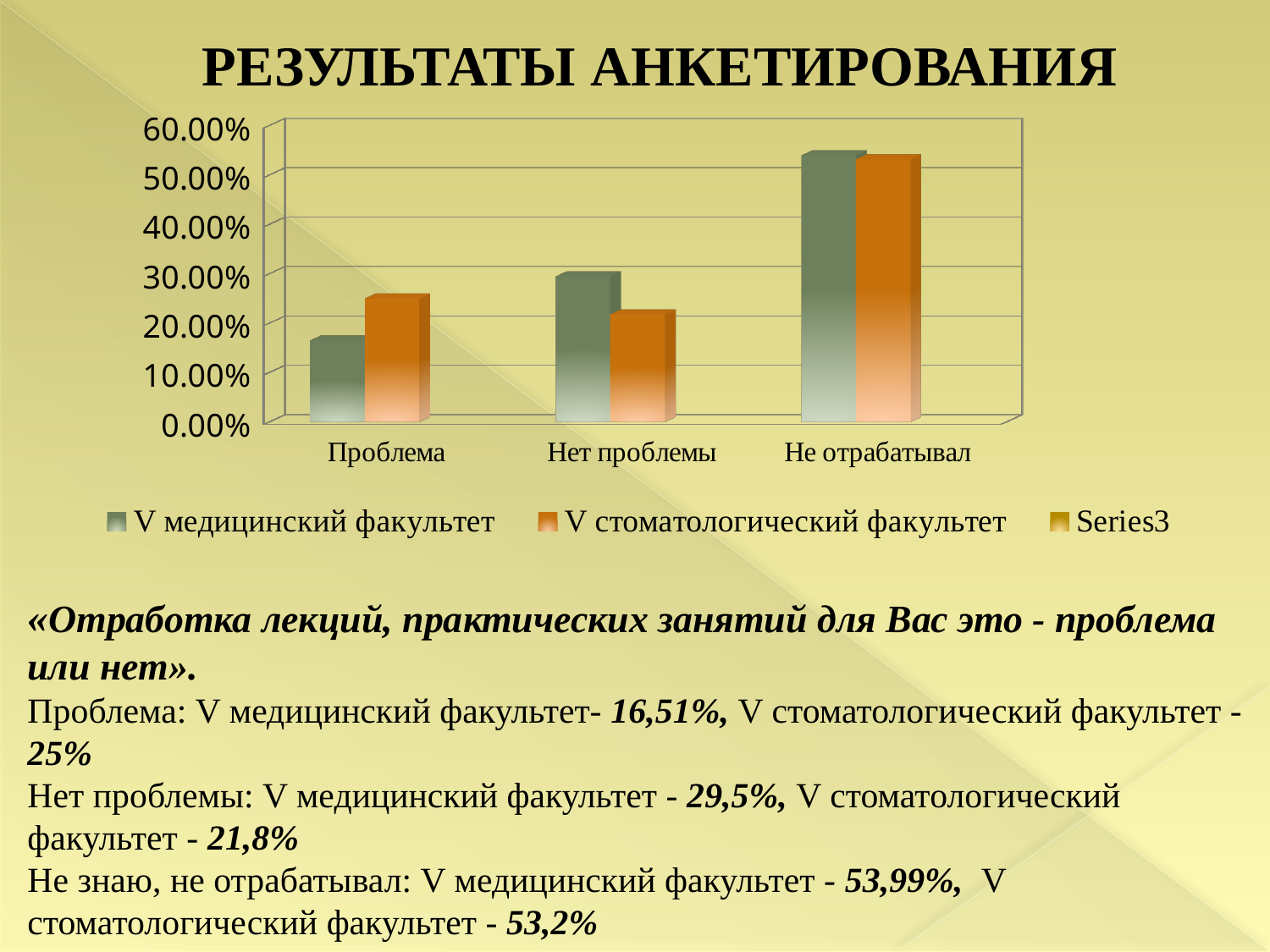
Is the value for V медицинский факультет in the Проблема category greater or less than 20.00%? less What kind of chart is shown on the slide? bar chart Which category has the highest value for V стоматологический факультет? Не отрабатывал In the Проблема category, which series has the larger value: V медицинский факультет or V стоматологический факультет? V стоматологический факультет Do the values for V медицинский факультет rise or fall from Проблема to Не отрабатывал along the x axis? rise What is the value for V стоматологический факультет in the Нет проблемы category? 21,8% What is the value for V медицинский факультет in the Проблема category? 16,51% Which category has the lowest value for V медицинский факультет? Проблема What is the value for V медицинский факультет in the Не отрабатывал category? 53,99% What is the difference between V медицинский факультет and V стоматологический факультет in the Нет проблемы category? 7,7% How many categories are shown on the x axis of the chart? 3 How many series does the chart legend list? 3